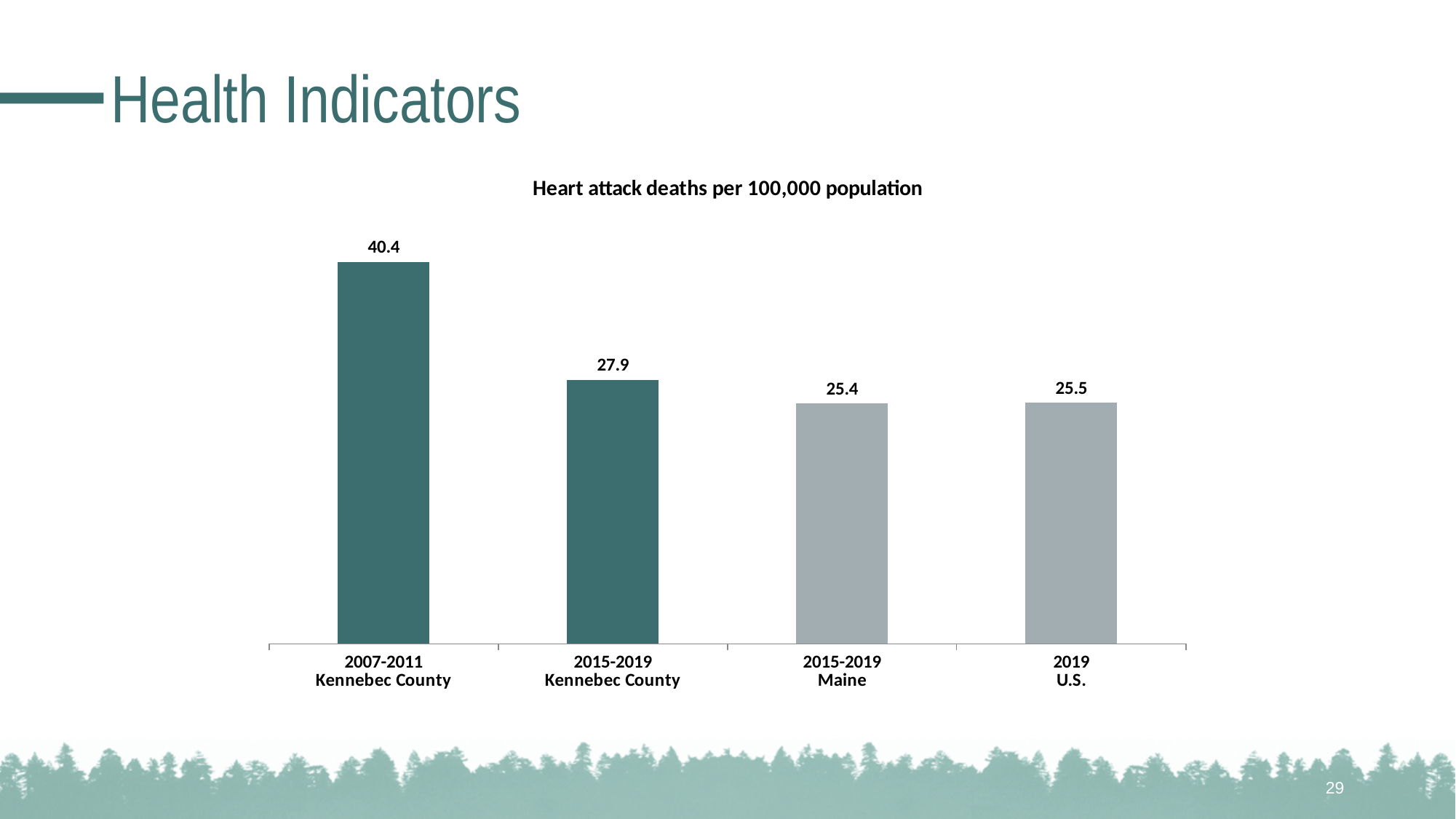
What is the value for 2019 U.S.? 25.5 How many bars are shown in the chart? 4 What is the difference between the 2007-2011 Kennebec County value and the 2015-2019 Kennebec County value? 12.5 What is the title of the chart? Heart attack deaths per 100,000 population Which is larger, the value for 2015-2019 Kennebec County or the value for 2019 U.S.? 2015-2019 Kennebec County What is the value for 2007-2011 Kennebec County? 40.4 Which category has the lowest value? 2015-2019 Maine What is the difference between the 2015-2019 Kennebec County value and the 2015-2019 Maine value? 2.5 What is the value for 2015-2019 Maine? 25.4 What kind of chart is shown on the slide? Bar chart What is the value for 2015-2019 Kennebec County? 27.9 Which category has the highest value? 2007-2011 Kennebec County